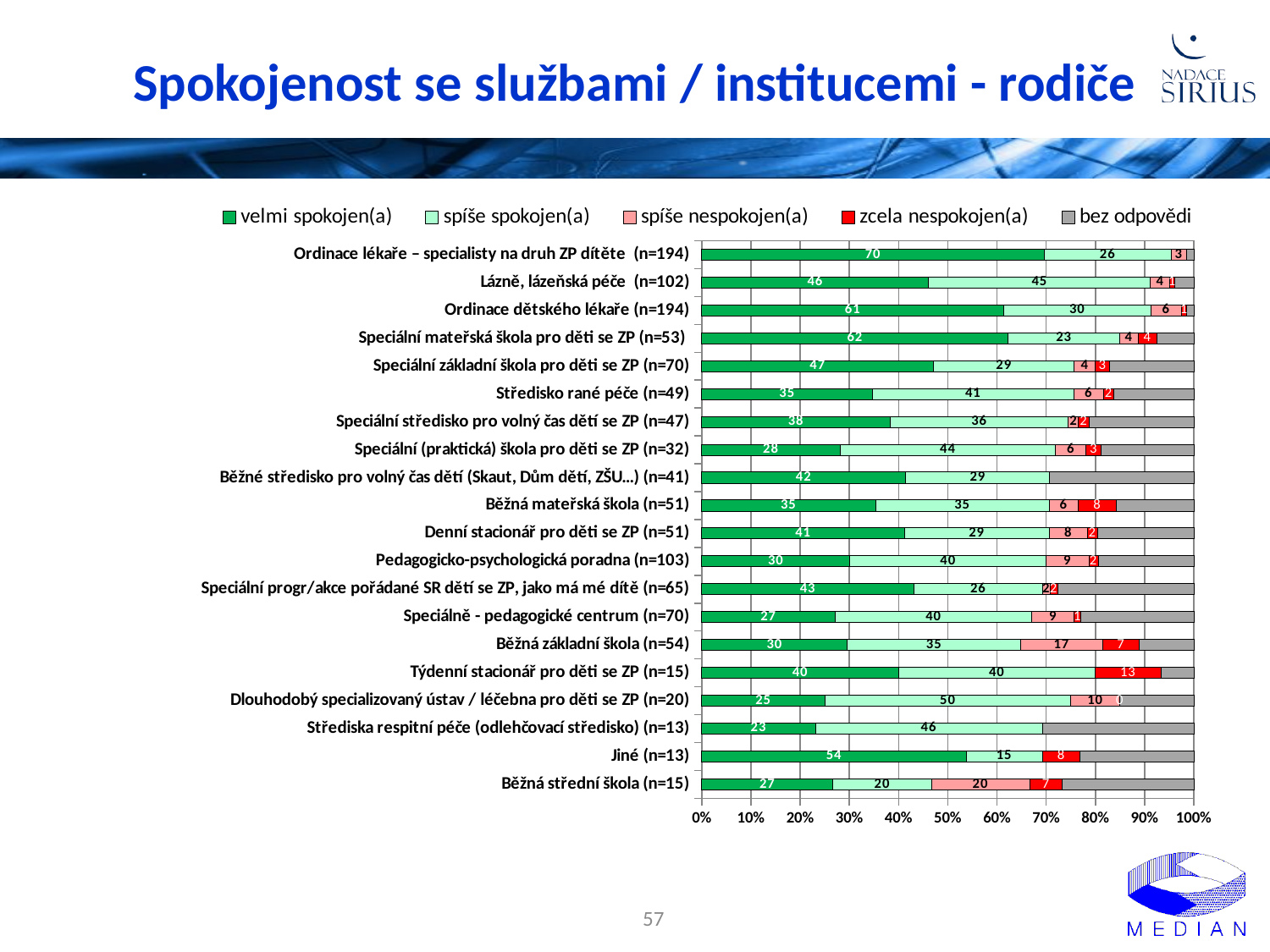
Is the "bez odpovědi" share for "Střediska respitní péče (odlehčovací středisko) (n=13)" greater or less than 20%? greater Which category has the lowest "velmi spokojen(a)" value? Střediska respitní péče (odlehčovací středisko) (n=13) How many categories are shown on the chart? 20 What kind of chart is shown on the slide? Stacked horizontal bar chart How many series does the legend list? 5 What is the value of "spíše spokojen(a)" for "Lázně, lázeňská péče (n=102)"? 45 What is the value of "zcela nespokojen(a)" for "Týdenní stacionář pro děti se ZP (n=15)"? 13 For "Ordinace dětského lékaře (n=194)", what is the difference between the "velmi spokojen(a)" and "spíše spokojen(a)" values? 31 Which category has the highest "velmi spokojen(a)" value? Ordinace lékaře – specialisty na druh ZP dítěte (n=194) What is the value of "velmi spokojen(a)" for "Ordinace lékaře – specialisty na druh ZP dítěte (n=194)"? 70 What is the value of "spíše nespokojen(a)" for "Běžná základní škola (n=54)"? 17 Which has a larger "velmi spokojen(a)" value: "Speciální mateřská škola pro děti se ZP (n=53)" or "Středisko rané péče (n=49)"? Speciální mateřská škola pro děti se ZP (n=53)